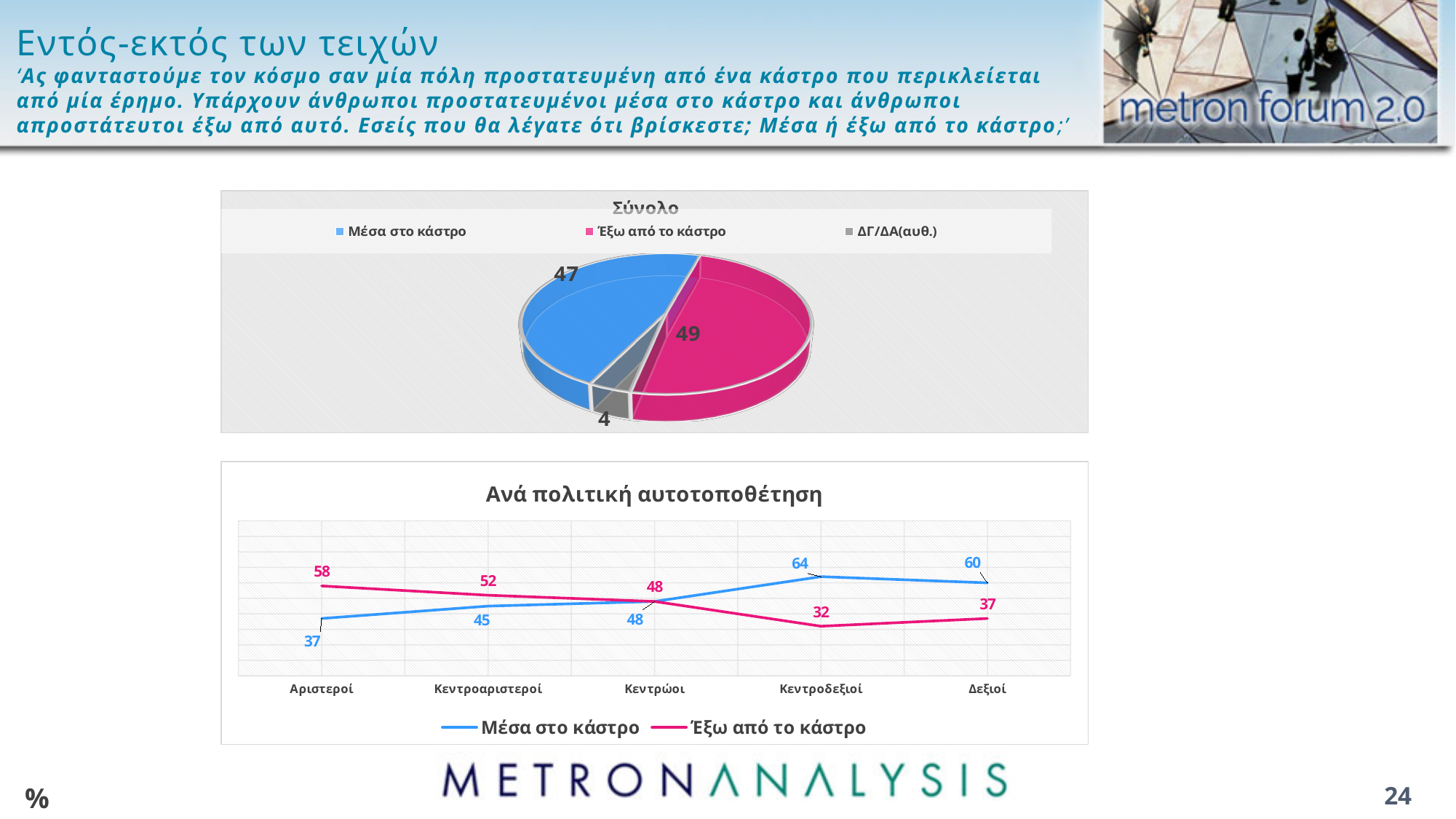
In the chart titled Ανά πολιτική αυτοτοποθέτηση, what is the value of Έξω από το κάστρο for Αριστεροί? 58 In the pie chart titled Σύνολο, what is the value for ΔΓ/ΔΑ(αυθ.)? 4 In the pie chart titled Σύνολο, how many slices are there? 3 In the chart titled Ανά πολιτική αυτοτοποθέτηση, what is the difference between Μέσα στο κάστρο and Έξω από το κάστρο for Δεξιοί? 23 In the chart titled Ανά πολιτική αυτοτοποθέτηση, does the Έξω από το κάστρο line rise or fall from Αριστεροί to Κεντροδεξιοί? Fall What kind of chart is the chart titled Ανά πολιτική αυτοτοποθέτηση? Line chart In the chart titled Ανά πολιτική αυτοτοποθέτηση, how many series does the legend list? 2 In the pie chart titled Σύνολο, what is the value for Μέσα στο κάστρο? 47 In the pie chart titled Σύνολο, which category has the largest slice? Έξω από το κάστρο In the chart titled Ανά πολιτική αυτοτοποθέτηση, what is the value of Μέσα στο κάστρο for Κεντροδεξιοί? 64 In the chart titled Ανά πολιτική αυτοτοποθέτηση, which category has the lowest value for Έξω από το κάστρο? Κεντροδεξιοί In the chart titled Ανά πολιτική αυτοτοποθέτηση, which is larger for Κεντροαριστεροί: Μέσα στο κάστρο or Έξω από το κάστρο? Έξω από το κάστρο